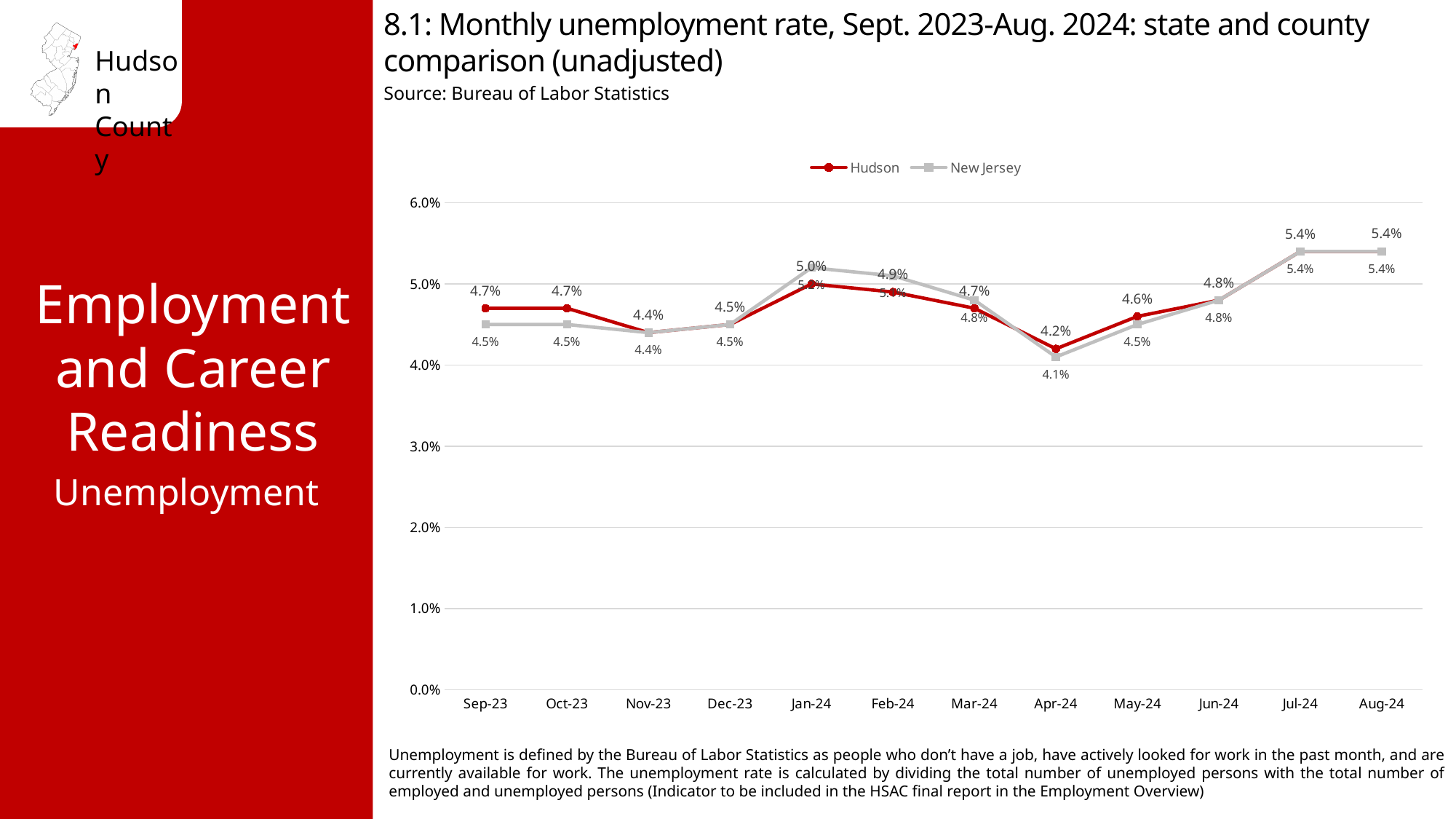
Does the Hudson unemployment rate rise or fall from Apr-24 to Jul-24? Rise What kind of chart is shown on the slide? Line chart Is the Hudson unemployment rate for Jul-24 greater or less than 5.0%? greater In Mar-24, which is higher: the Hudson rate or the New Jersey rate? New Jersey What is the Hudson unemployment rate for Nov-23? 4.4% What is the New Jersey unemployment rate for Apr-24? 4.1% In which month is the New Jersey unemployment rate lowest? Apr-24 What is the difference between the Hudson and New Jersey unemployment rates in Sep-23? 0.2 percentage points How many months are plotted along the x axis? 12 In which month is the Hudson unemployment rate lowest? Apr-24 What is the Hudson unemployment rate for Apr-24? 4.2% How many series does the legend list? 2